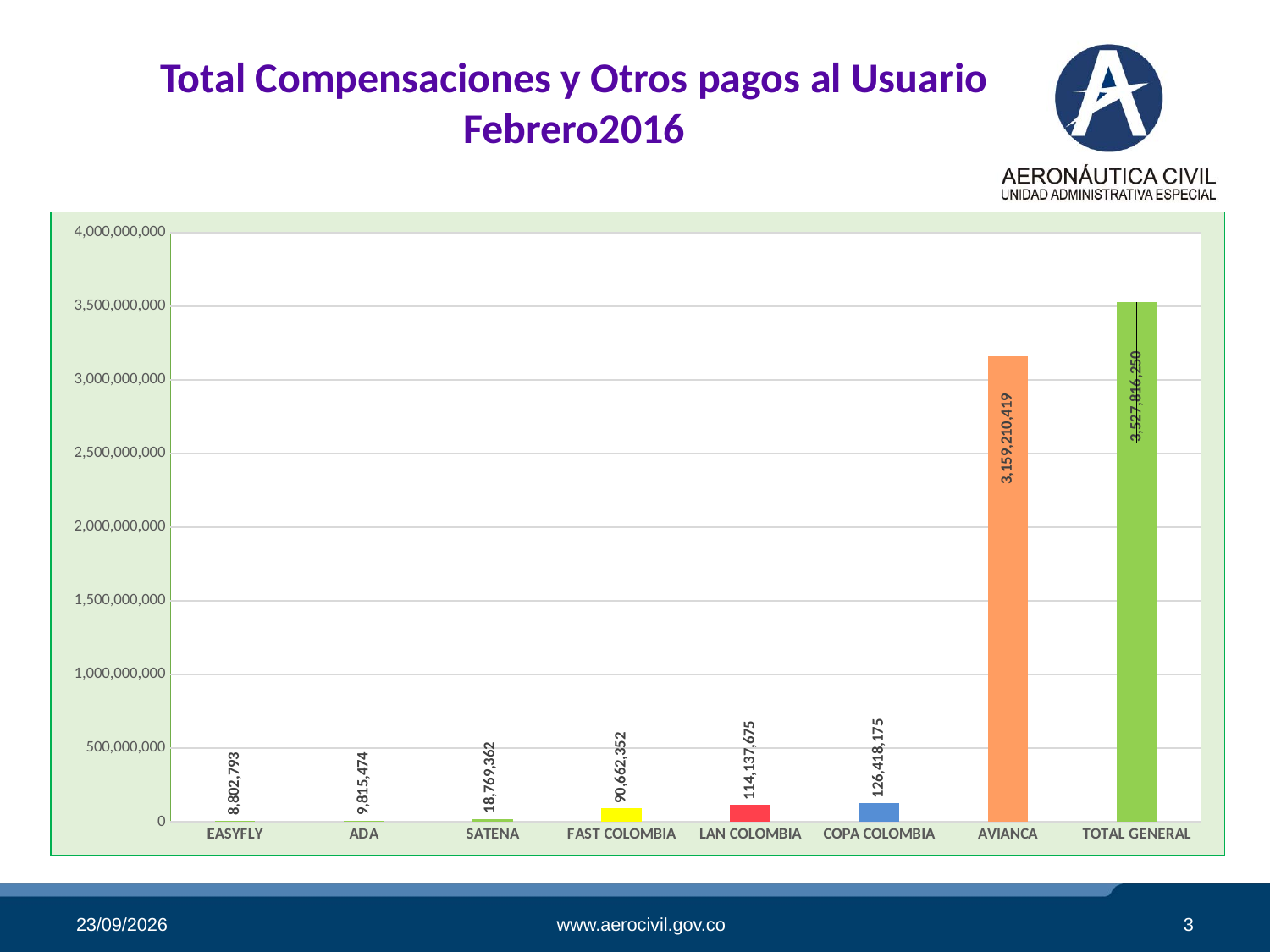
How many categories are shown on the x axis? 8 What is the difference between the values for COPA COLOMBIA and LAN COLOMBIA? 12,280,500 What is the value shown for TOTAL GENERAL? 3,527,816,250 What is the value for EASYFLY? 8,802,793 Which is larger, the value for SATENA or the value for ADA? SATENA What kind of chart is shown on the slide? Bar chart Which category has the lowest value? EASYFLY What is the difference between TOTAL GENERAL and AVIANCA? 368,605,831 What is the value for AVIANCA? 3,159,210,419 Excluding TOTAL GENERAL, which airline has the highest value? AVIANCA What is the value for COPA COLOMBIA? 126,418,175 Is the value for AVIANCA greater or less than 3,000,000,000? greater